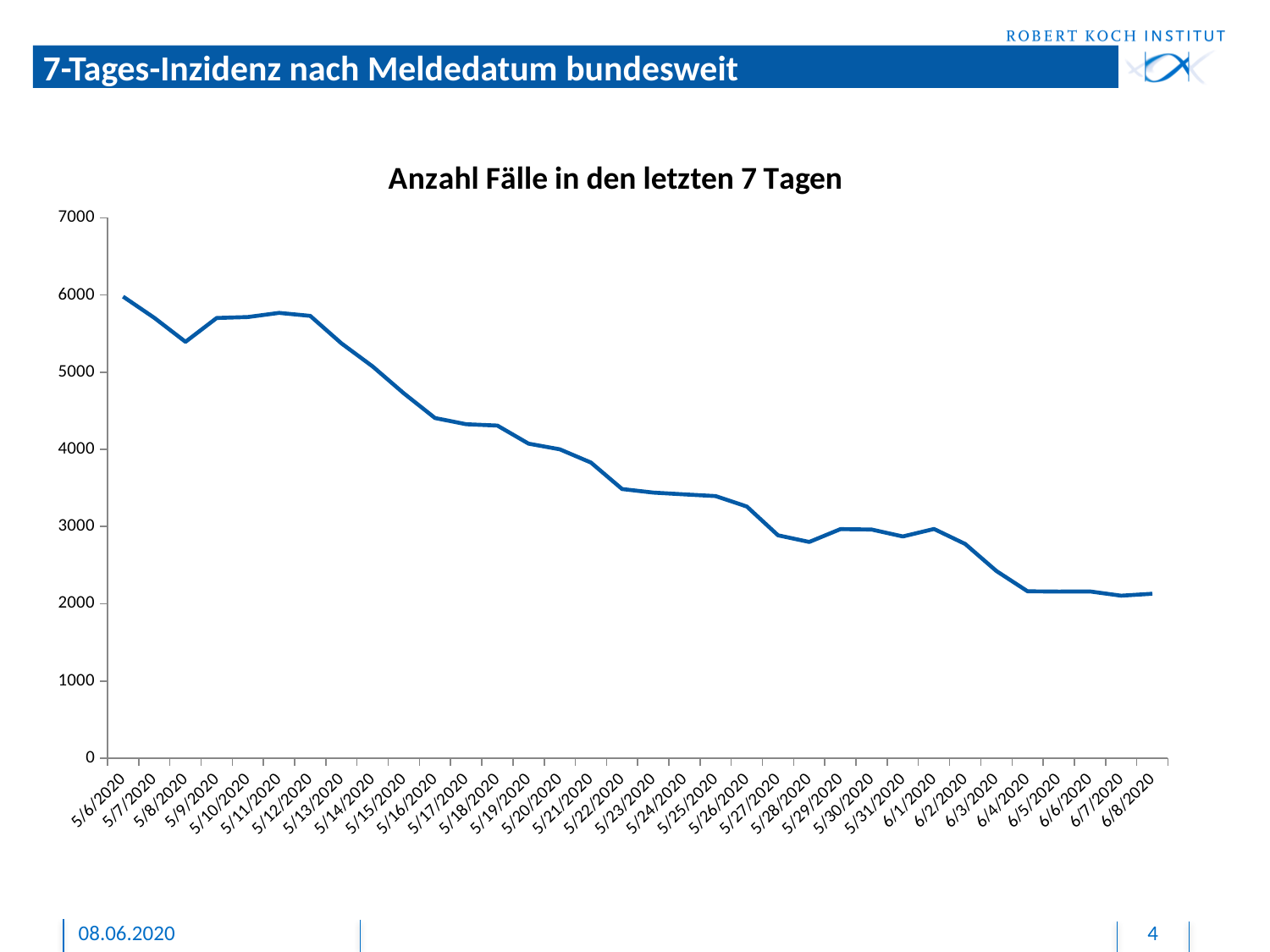
What is the title of the chart? Anzahl Fälle in den letzten 7 Tagen Is the value for 5/22/2020 greater or less than 4000? less Which is larger, the value for 5/13/2020 or the value for 5/20/2020? 5/13/2020 What kind of chart is shown on the slide? line chart What is the highest value shown on the y axis? 7000 Is the value for 5/16/2020 greater or less than 4000? greater Is the value for 5/6/2020 greater or less than 5000? greater How many dates are plotted on the x axis? 34 Which date has the highest value? 5/6/2020 Do the values generally rise or fall from 5/6/2020 to 6/8/2020? fall